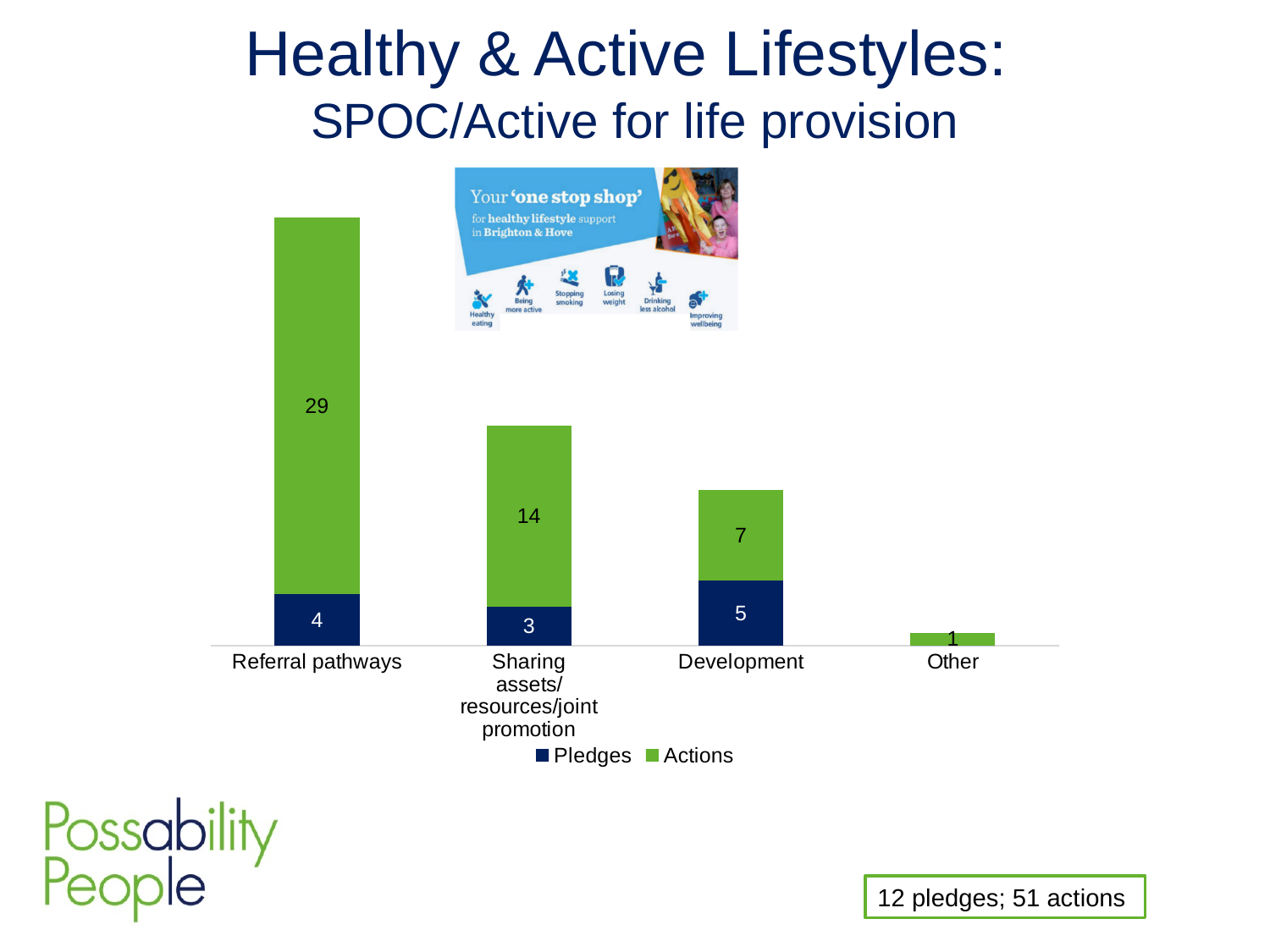
Which category has the highest Actions value? Referral pathways How many series does the legend list? 2 Which category has the lowest Actions value? Other Which colour represents the Actions series in the legend? Green What is the Pledges value for Development? 5 What is the difference between the Actions values for Referral pathways and Development? 22 What is the Actions value for Sharing assets/resources/joint promotion? 14 Which is larger, the Pledges value for Development or the Pledges value for Referral pathways? Development How many categories are shown on the x axis? 4 What is the Actions value for Referral pathways? 29 What is the total of the stacked bar for Sharing assets/resources/joint promotion? 17 What kind of chart is shown on the slide? Stacked bar chart